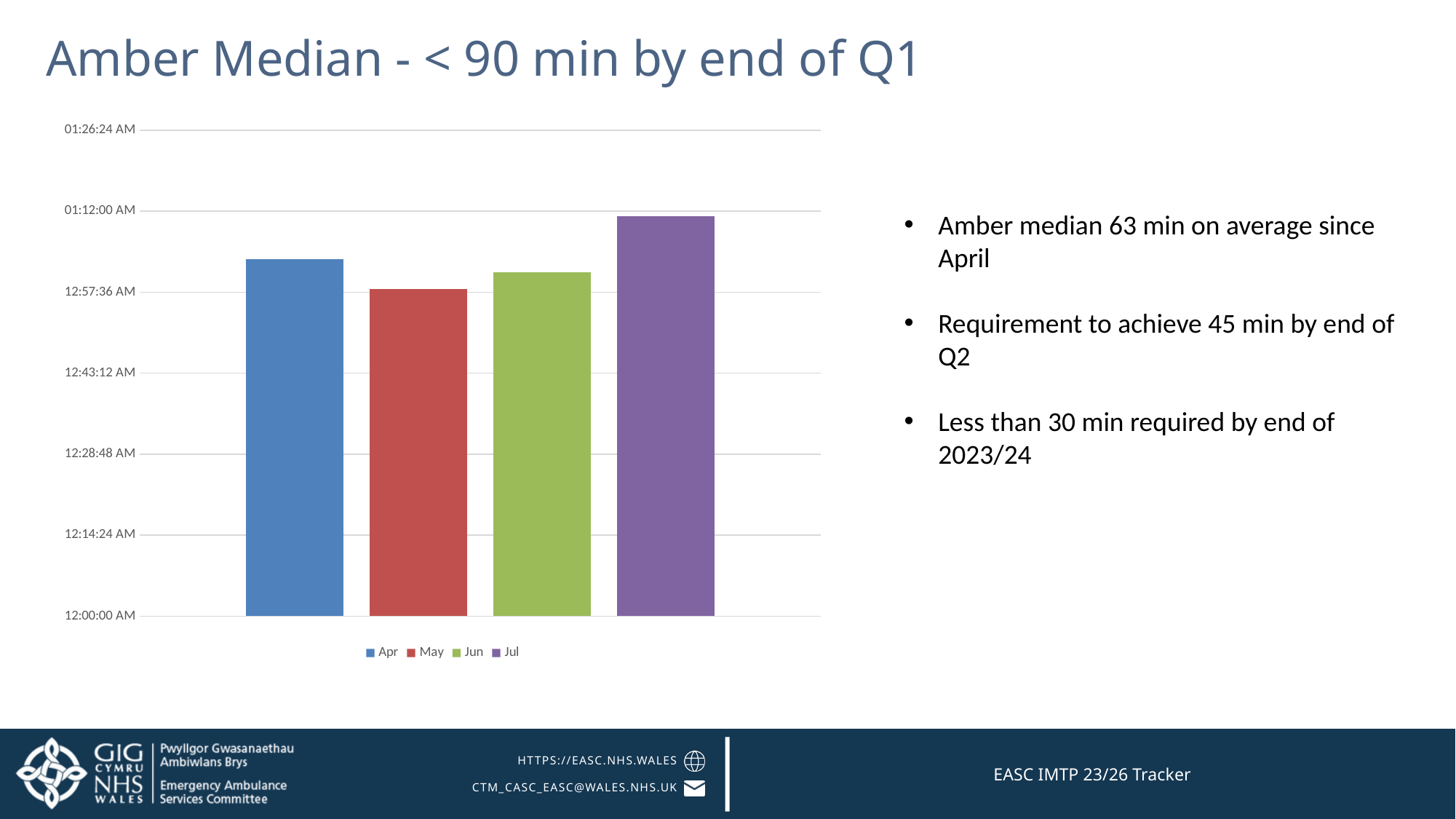
How many series does the chart legend list? 4 Is the value for Apr greater or less than 01:12:00 AM? less Which is larger, the value for Apr or the value for Jun? Apr What colour is the bar for Jul in the chart? purple Which month has the highest bar in the chart? Jul How many bars are plotted in the chart? 4 Which month has the lowest bar in the chart? May Which is larger, the value for Jul or the value for Jun? Jul Is the value for Jul greater or less than 12:57:36 AM? greater Which is larger, the value for Apr or the value for May? Apr What kind of chart is shown on the slide? bar chart Is the value for May greater or less than 12:43:12 AM? greater